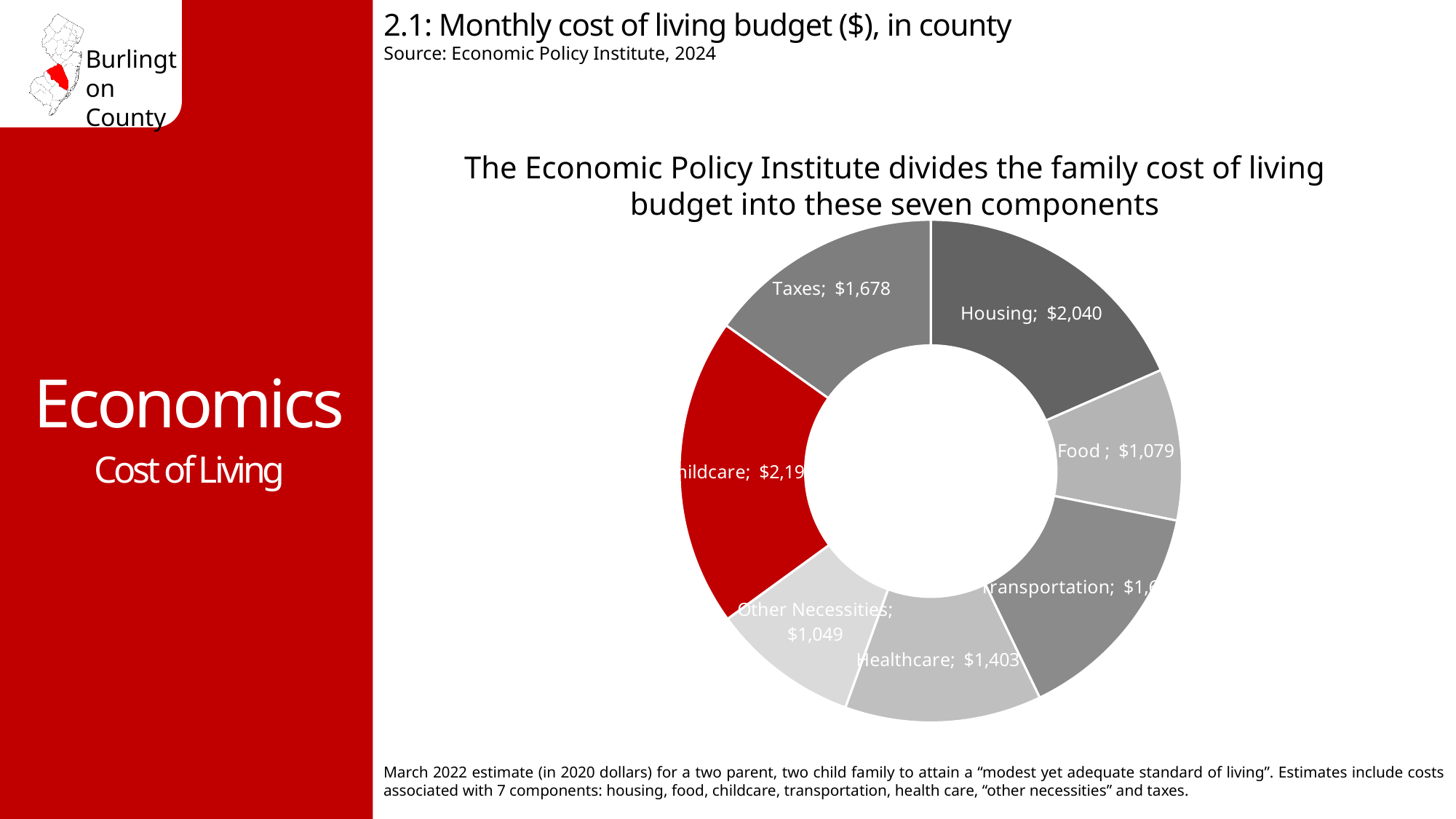
What is the monthly cost for Other Necessities shown on the chart? $1,049 Which is larger, the monthly cost for Food or for Other Necessities? Food What is the difference between the Healthcare and Food monthly costs? $324 What is the monthly cost for Taxes shown on the chart? $1,678 What kind of chart is shown on the slide? Donut (pie) chart What is the monthly cost for Food shown on the chart? $1,079 What is the difference between the Housing and Taxes monthly costs? $362 Which component is shown in red on the chart? Childcare How many components (slices) does the chart show? 7 What is the monthly cost for Healthcare shown on the chart? $1,403 What is the monthly cost for Housing shown on the chart? $2,040 Which component has the largest monthly cost on the chart? Childcare